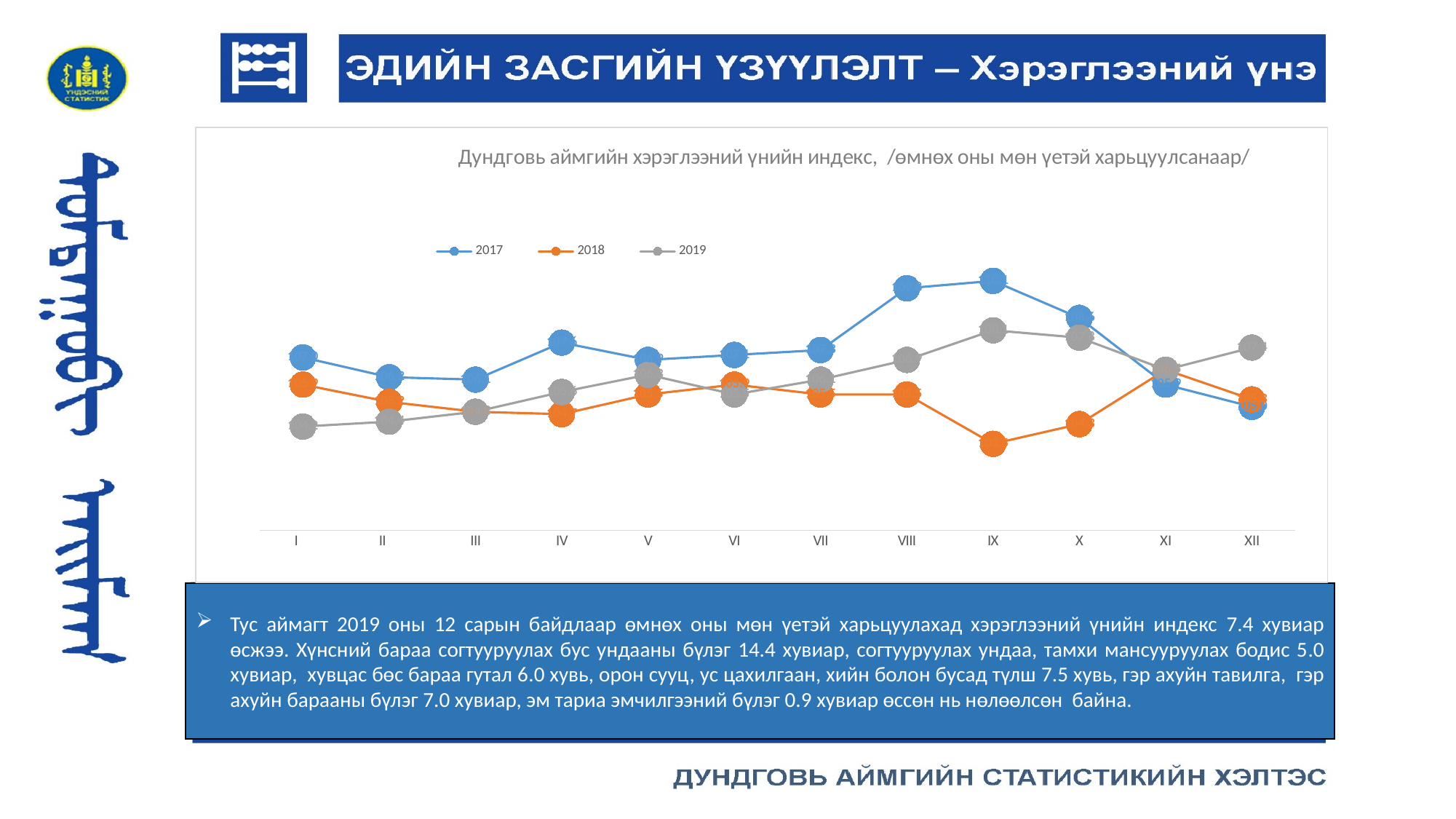
In which month does the 2019 series reach its lowest value? I How many series does the legend list? 3 What kind of chart is shown on the slide? Line chart In which month does the 2017 series reach its highest value? IX In which month does the 2017 series reach its lowest value? XII In month XII, which series has the higher value, 2017 or 2019? 2019 Which years are listed in the legend? 2017, 2018, 2019 In month IX, which series has the higher value, 2017 or 2018? 2017 What is the title of the chart? Дундговь аймгийн хэрэглээний үнийн индекс, /өмнөх оны мөн үетэй харьцуулсанаар/ In which month does the 2018 series reach its lowest value? IX Does the 2017 series rise or fall from month IX to month XII? Fall How many points (months) are plotted along the x axis? 12